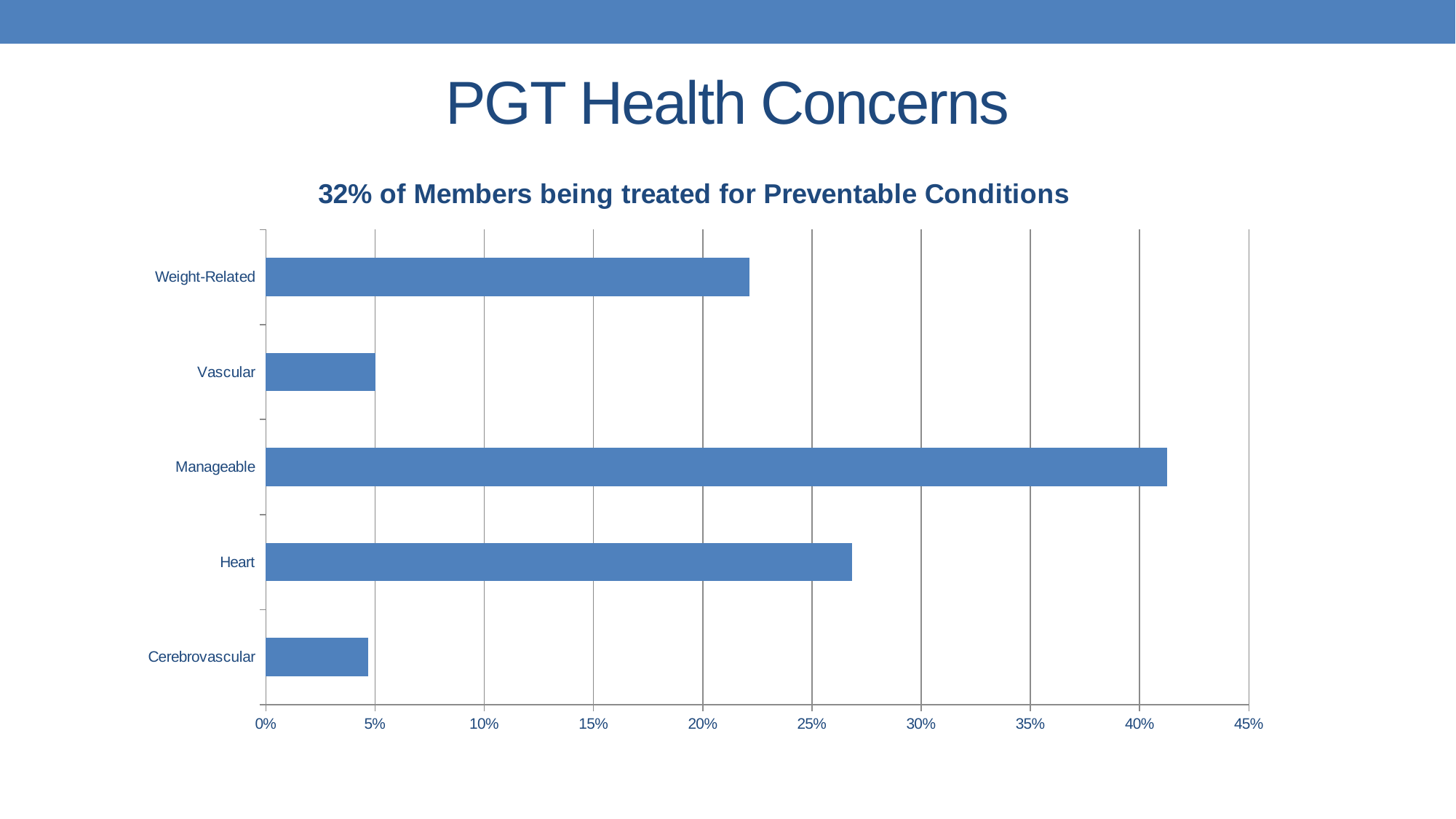
Is the value for Heart greater or less than 25%? greater What is the title of the chart? 32% of Members being treated for Preventable Conditions Which is larger, the value for Manageable or the value for Vascular? Manageable Is the value for Manageable greater or less than 40%? greater Is the value for Weight-Related greater or less than 20%? greater Which is larger, the value for Heart or the value for Weight-Related? Heart How many categories are plotted in the chart? 5 What kind of chart is shown on the slide? bar chart Which category has the highest value in the chart? Manageable